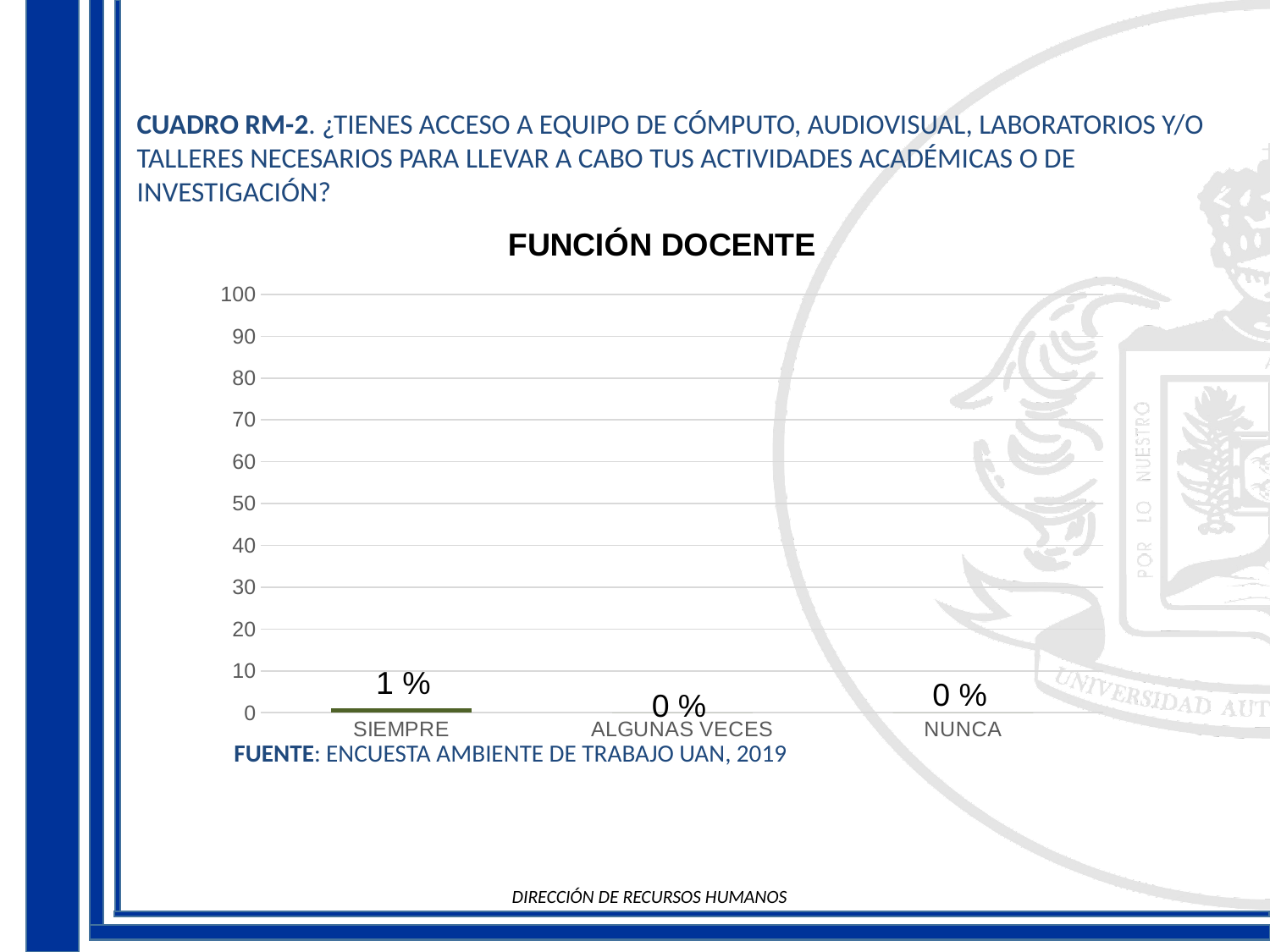
How many categories are shown on the x axis? 3 What is the title of the chart? FUNCIÓN DOCENTE Is the value for SIEMPRE greater or less than 10? less Which category has the highest value? SIEMPRE What is the value for ALGUNAS VECES? 0 % What is the difference between the values for SIEMPRE and NUNCA? 1 % Which is larger, the value for SIEMPRE or the value for ALGUNAS VECES? SIEMPRE What is the value for NUNCA? 0 % What kind of chart is shown? bar chart What is the highest value shown on the y axis? 100 What is the value for SIEMPRE? 1 %